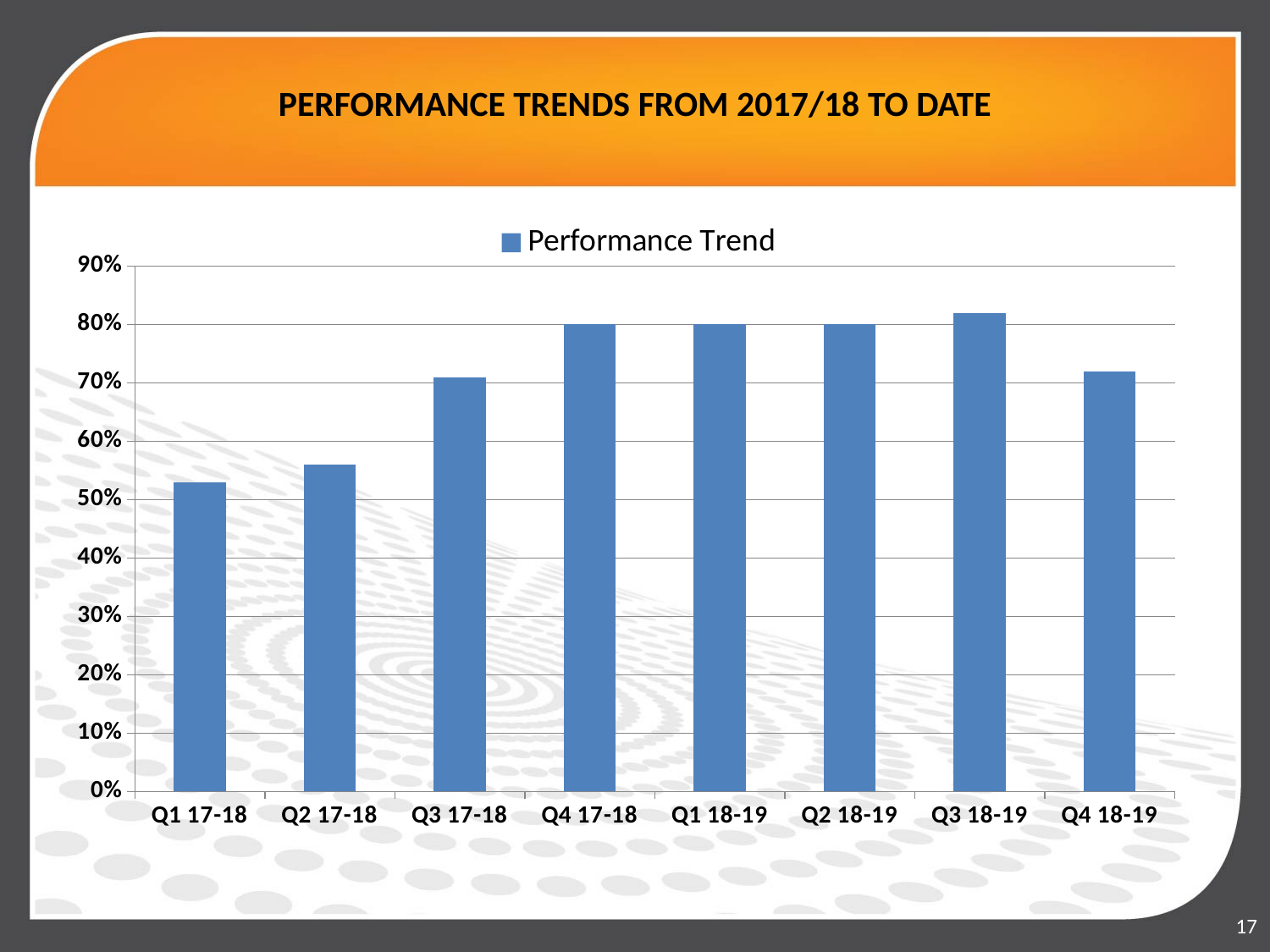
How many quarters are plotted on the x axis of the chart? 8 Do the values rise or fall from Q1 17-18 to Q4 17-18? rise What kind of chart is shown on the slide? bar chart Is the value for Q1 17-18 greater or less than 60%? less What is the value for Q4 17-18? 80% Is the value for Q3 17-18 greater or less than 60%? greater How many series does the chart legend list? 1 Which quarter has the lowest value in the chart? Q1 17-18 What is the name of the series shown in the chart legend? Performance Trend Which quarter has the highest value in the chart? Q3 18-19 Which is larger, the value for Q2 17-18 or the value for Q4 18-19? Q4 18-19 What is the value for Q2 18-19? 80%